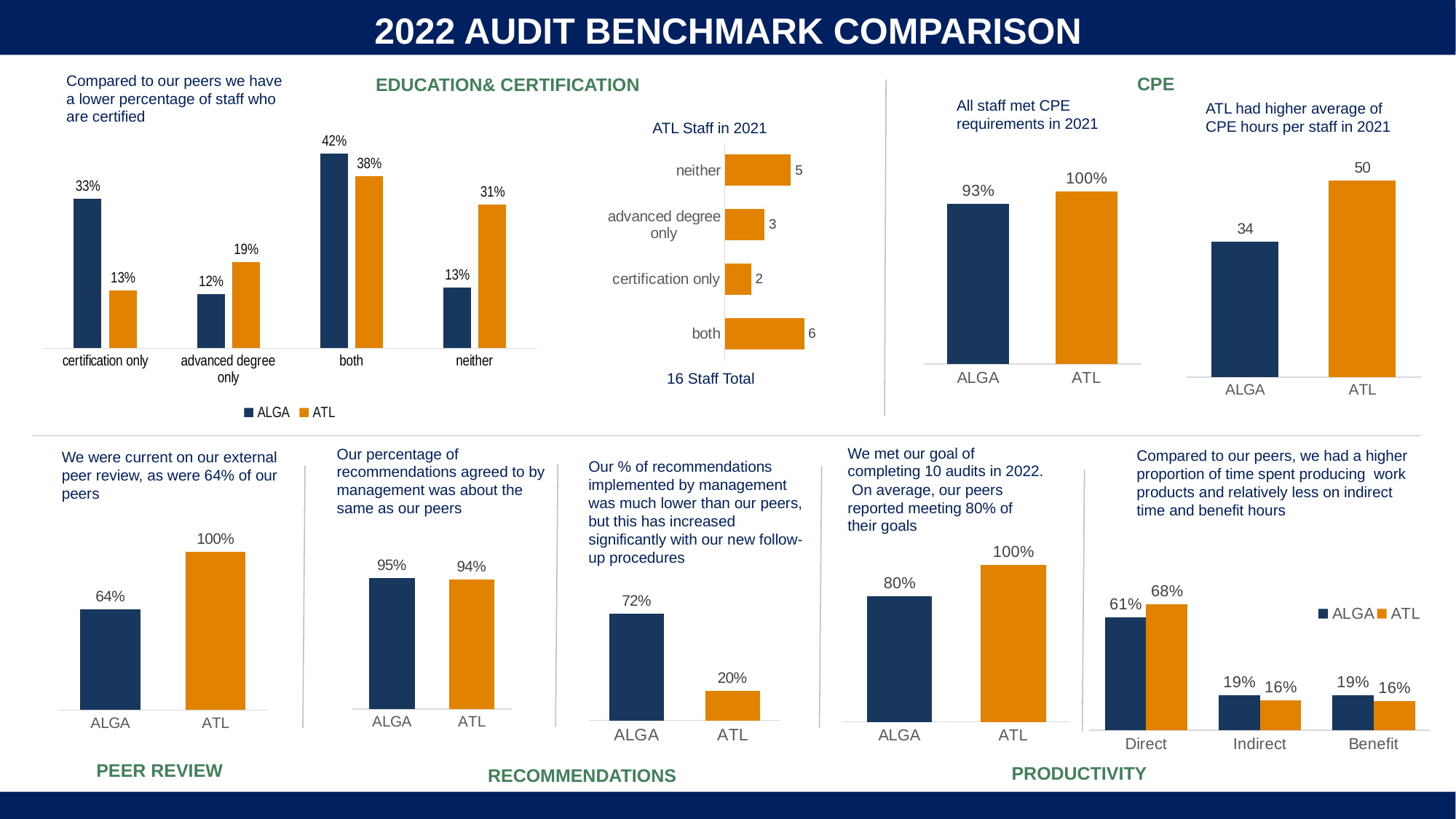
How many series does the legend of the Productivity chart list? 2 In the Education & Certification grouped bar chart, what is the ALGA value for 'both'? 42% In the Peer Review chart, what is the value for ALGA? 64% In the 'ATL Staff in 2021' chart, which category has the highest value? both In the CPE chart of average CPE hours per staff in 2021, what is the value for ALGA? 34 In the Recommendations chart showing the percentage of recommendations implemented by management, which is larger, ALGA or ATL? ALGA In the CPE chart of average CPE hours per staff in 2021, what is the difference between ATL and ALGA? 16 In the Education & Certification grouped bar chart, what is the ATL value for 'neither'? 31% What kind of chart is the 'ATL Staff in 2021' chart? Bar chart In the Productivity chart, what is the ATL value for 'Direct'? 68% In the 'ATL Staff in 2021' chart, how many categories are shown? 4 In the Education & Certification grouped bar chart, what is the difference between the ALGA and ATL values for 'certification only'? 20%